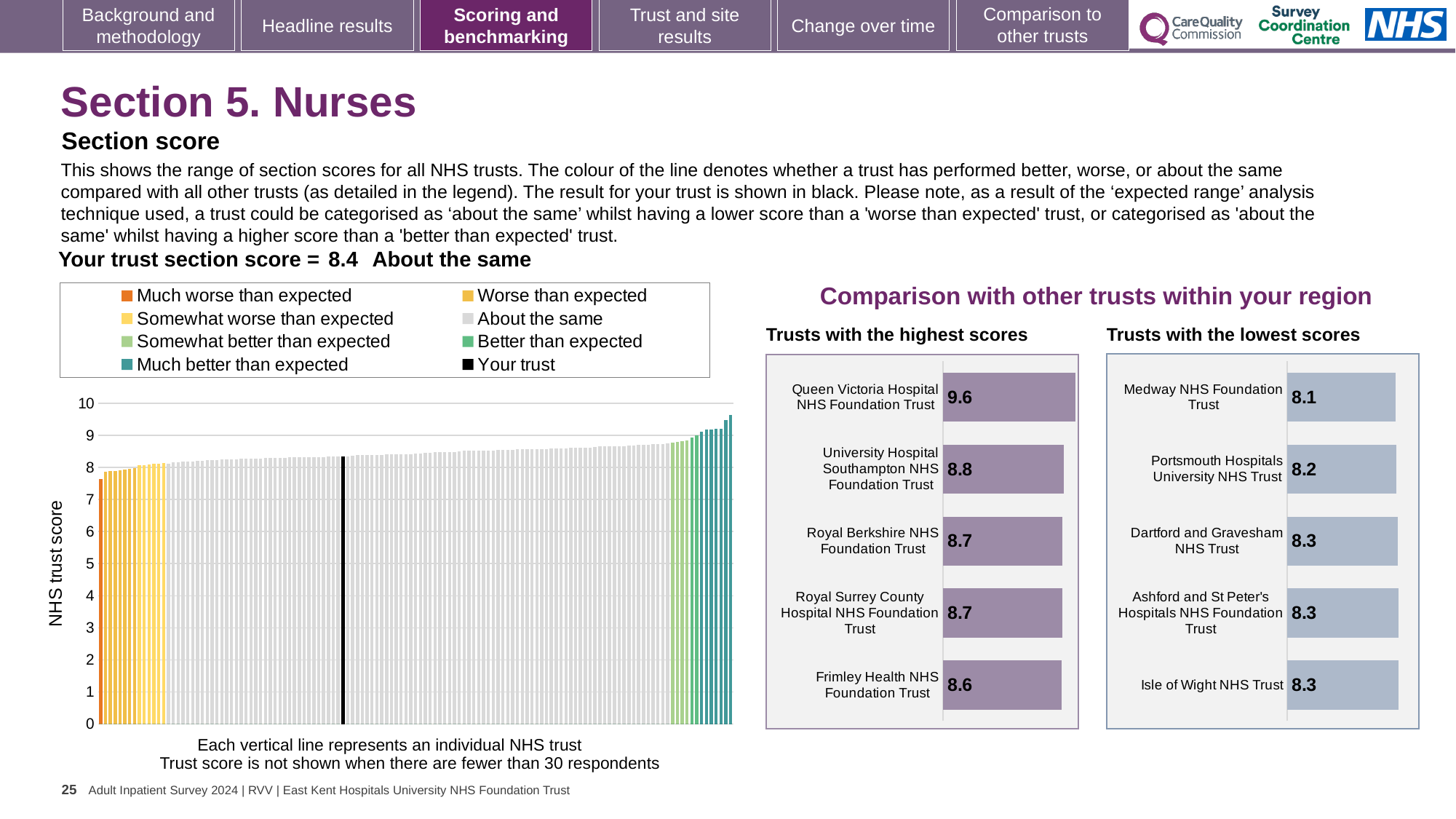
What kind of chart is the large chart on the left showing NHS trust scores? Bar chart In the 'Trusts with the highest scores' chart, which trust has the highest score? Queen Victoria Hospital NHS Foundation Trust In the large NHS trust score chart, do the values rise or fall from left to right along the x axis? Rise In the 'Trusts with the lowest scores' chart, what is the score for Medway NHS Foundation Trust? 8.1 In the 'Trusts with the highest scores' chart, what is the score for Queen Victoria Hospital NHS Foundation Trust? 9.6 In the 'Trusts with the lowest scores' chart, which trust has the lowest score? Medway NHS Foundation Trust How many entries does the legend of the large NHS trust score chart list? 8 How many trusts are shown in the 'Trusts with the lowest scores' chart? 5 In the 'Trusts with the lowest scores' chart, what is the difference between the scores of Portsmouth Hospitals University NHS Trust and Medway NHS Foundation Trust? 0.1 According to the slide, what is your trust's section score for Section 5. Nurses? 8.4 In the 'Trusts with the highest scores' chart, what is the difference between the scores of Queen Victoria Hospital NHS Foundation Trust and Frimley Health NHS Foundation Trust? 1.0 In the 'Trusts with the highest scores' chart, which has the higher score: University Hospital Southampton NHS Foundation Trust or Royal Berkshire NHS Foundation Trust? University Hospital Southampton NHS Foundation Trust